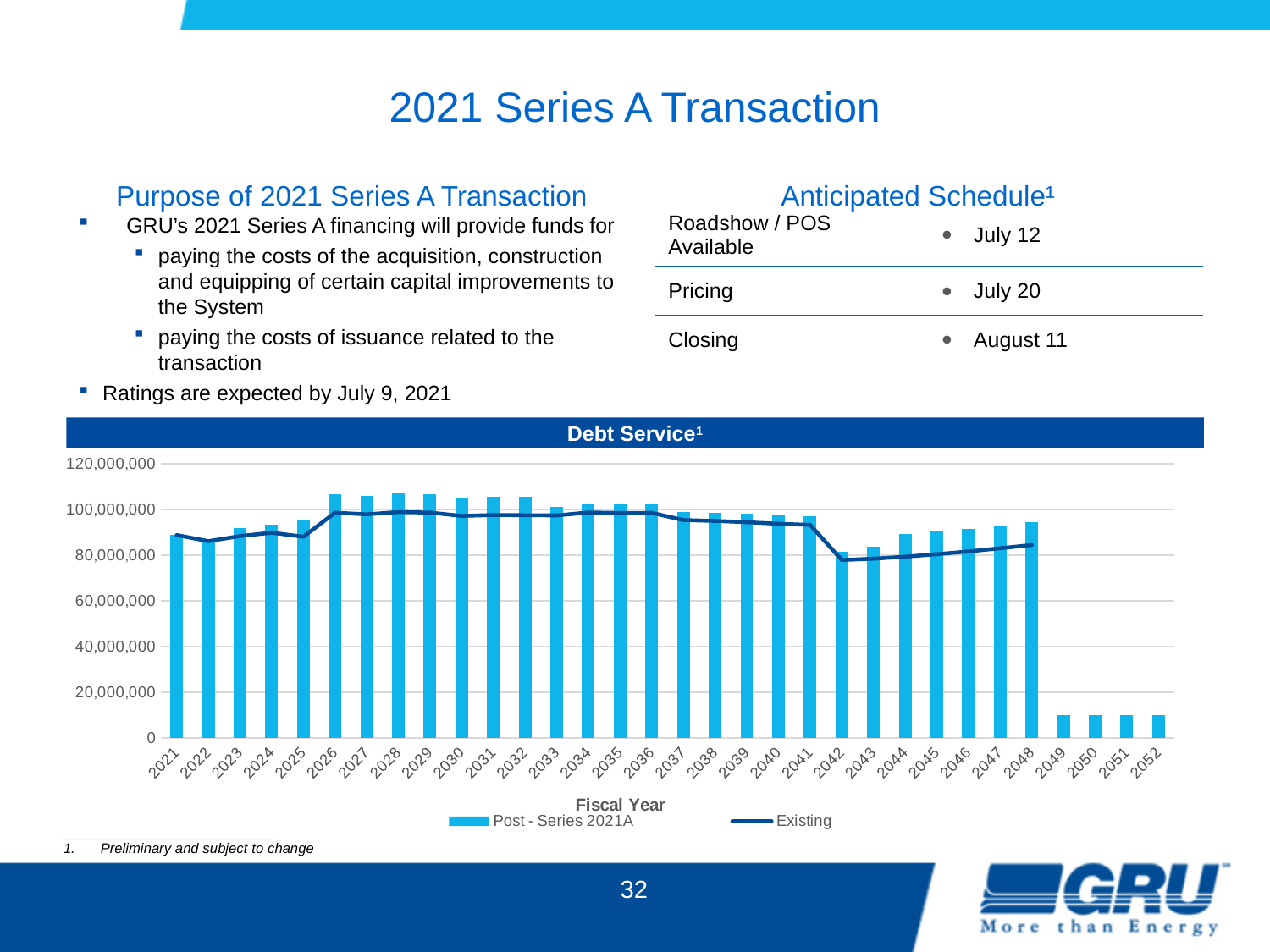
Is the Post - Series 2021A value for 2028 greater or less than 100,000,000? greater Which has the larger Post - Series 2021A value, 2028 or 2042? 2028 Do the Post - Series 2021A values rise or fall from 2048 to 2049? fall What kind of chart is the Debt Service chart? bar chart with a line How many series does the legend of the Debt Service chart list? 2 What are the two series named in the legend of the Debt Service chart? Post - Series 2021A and Existing How many fiscal years are shown on the x axis of the Debt Service chart? 32 Is the Existing value for 2021 greater or less than 100,000,000? less Is the Post - Series 2021A value for 2049 greater or less than 20,000,000? less Which has the larger Post - Series 2021A value, 2048 or 2049? 2048 What is the label of the x axis on the Debt Service chart? Fiscal Year